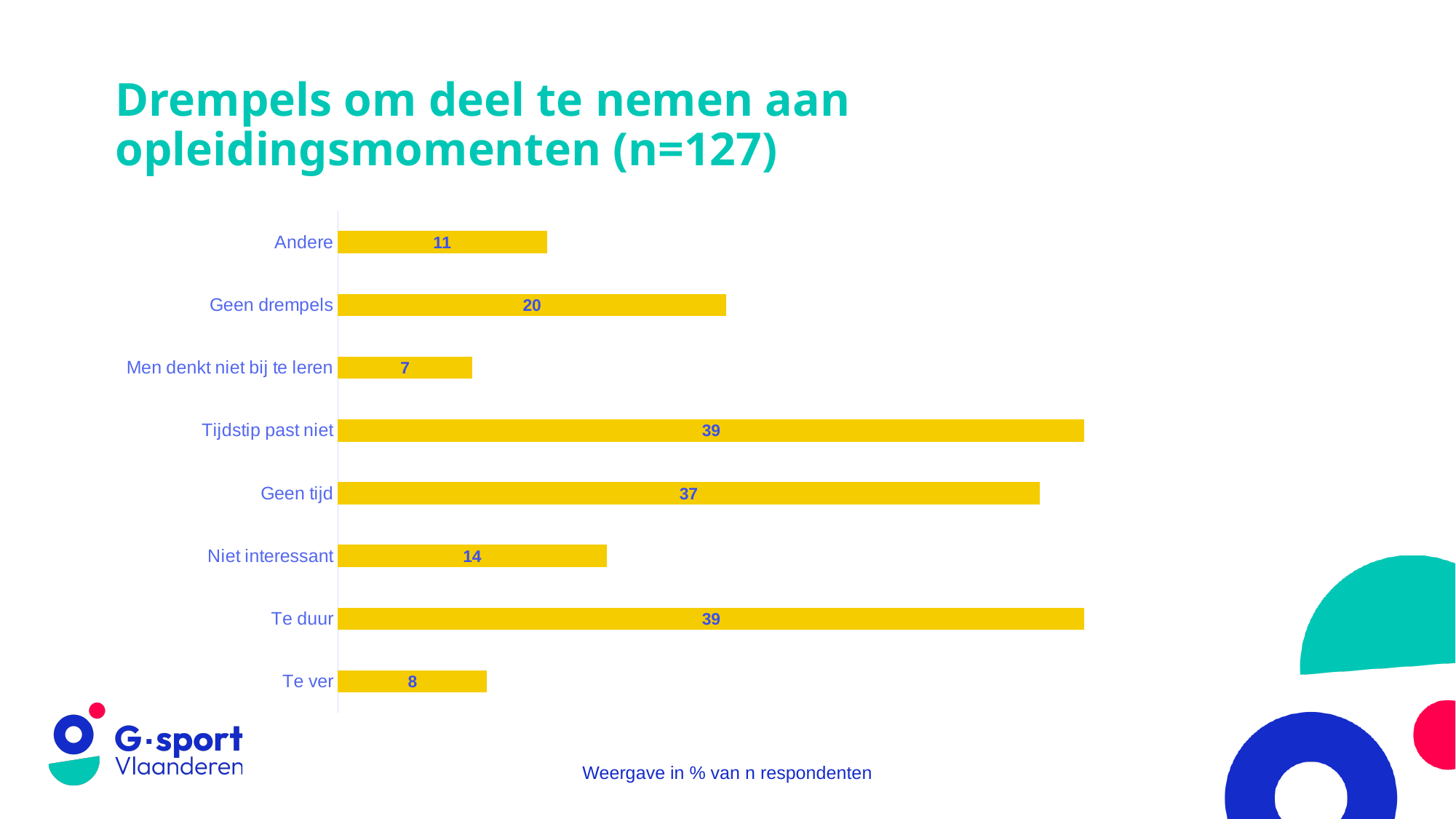
What is the value for 'Geen tijd'? 37 How many categories are shown in the chart? 8 What is the value for 'Niet interessant'? 14 Which category has the lowest value? Men denkt niet bij te leren What is the value for 'Geen drempels'? 20 What kind of chart is shown on the slide? bar chart Which is larger, the value for 'Niet interessant' or the value for 'Andere'? Niet interessant What is the highest value shown in the chart? 39 What is the value for 'Te ver'? 8 What is the title of the chart on the slide? Drempels om deel te nemen aan opleidingsmomenten (n=127) What is the difference between the values for 'Tijdstip past niet' and 'Geen tijd'? 2 What is the difference between the values for 'Geen drempels' and 'Andere'? 9